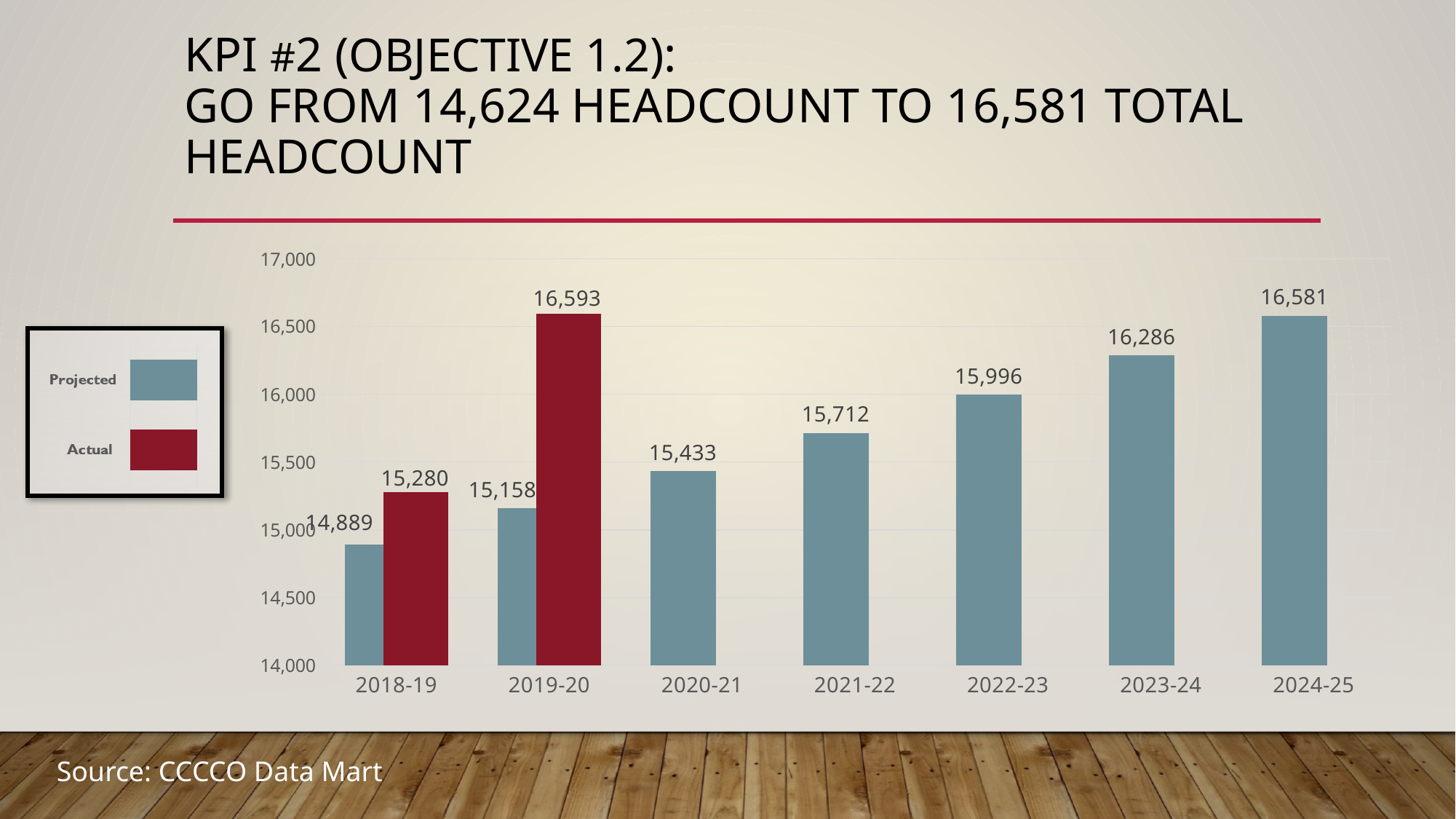
What is the projected headcount for 2018-19? 14,889 Which is larger for 2018-19, the projected or the actual headcount? Actual Is the projected headcount for 2021-22 greater or less than 16,000? less What kind of chart is shown on the slide? Bar chart Which year has the highest projected headcount? 2024-25 What is the actual headcount for 2019-20? 16,593 What is the projected headcount for 2022-23? 15,996 What is the difference between the actual and projected headcount for 2019-20? 1,435 How many series does the legend list? 2 Do the projected headcount values rise or fall from 2018-19 to 2024-25? Rise How many academic years are shown on the x axis? 7 Which year has the lowest projected headcount? 2018-19